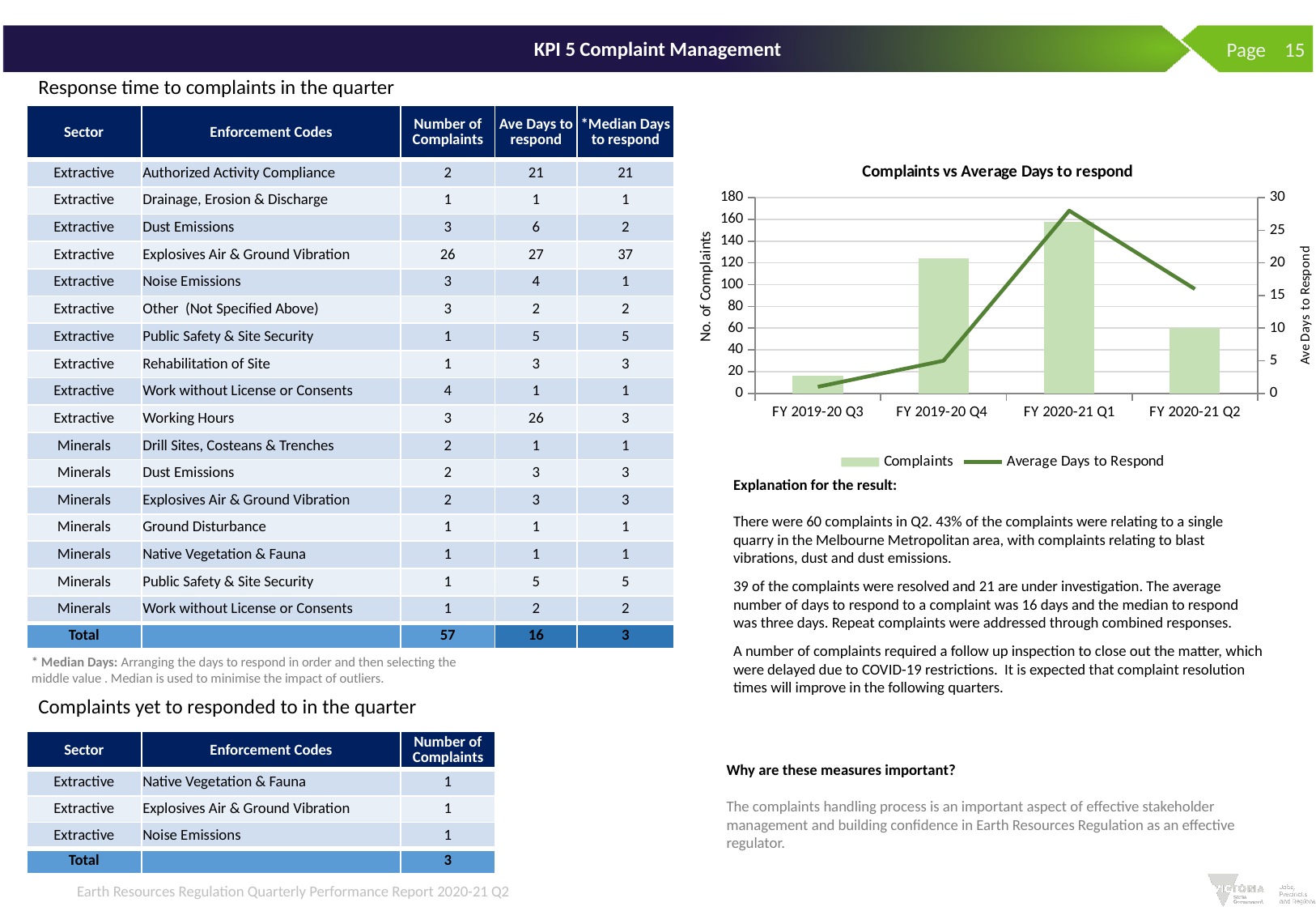
How many series does the legend of the 'Complaints vs Average Days to respond' chart list? 2 In the 'Complaints vs Average Days to respond' chart, which quarter has the highest number of complaints? FY 2020-21 Q1 What kind of chart is 'Complaints vs Average Days to respond'? A combination bar and line chart In the 'Complaints vs Average Days to respond' chart, is the average days to respond for FY 2020-21 Q1 greater or less than 25? greater In the 'Complaints vs Average Days to respond' chart, is the number of complaints for FY 2019-20 Q4 greater or less than 100? greater In the 'Complaints vs Average Days to respond' chart, which quarter has the lowest number of complaints? FY 2019-20 Q3 In the 'Complaints vs Average Days to respond' chart, is the number of complaints for FY 2020-21 Q1 greater or less than 140? greater In the 'Complaints vs Average Days to respond' chart, what is the label of the right-hand vertical axis? Ave Days to Respond How many quarters are shown on the x axis of the 'Complaints vs Average Days to respond' chart? 4 In the 'Complaints vs Average Days to respond' chart, which quarter has the highest average days to respond? FY 2020-21 Q1 In the 'Complaints vs Average Days to respond' chart, which quarter has more complaints, FY 2019-20 Q4 or FY 2020-21 Q2? FY 2019-20 Q4